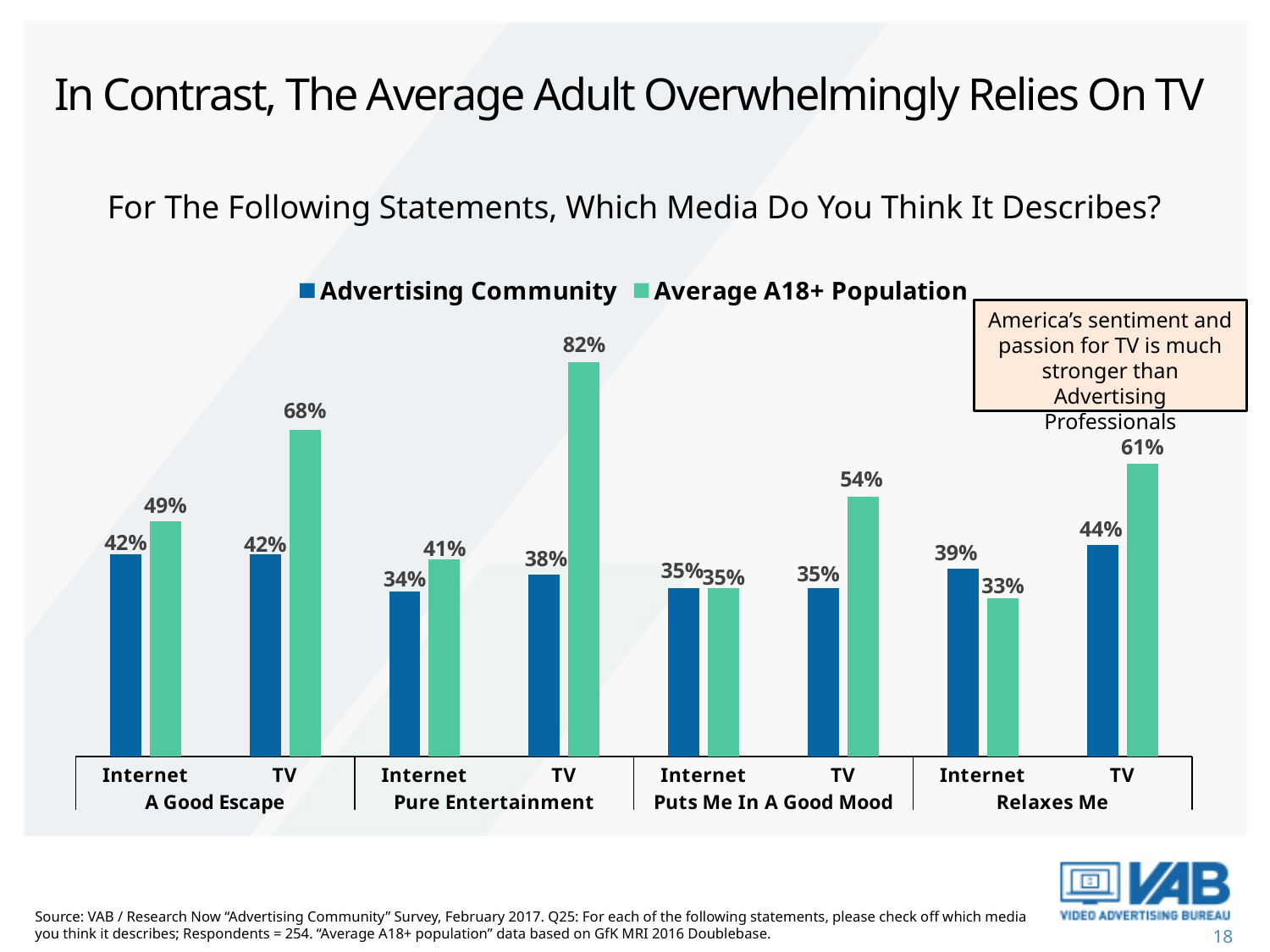
What is the Advertising Community value for Internet under Relaxes Me? 39% What kind of chart is shown on the slide? Bar chart How many statement groups are shown along the x axis? 4 Which colour represents the Average A18+ Population series? Green What is the difference between the Average A18+ Population and Advertising Community values for TV under Pure Entertainment? 44 percentage points Which bar has the highest value in the chart? Average A18+ Population, TV, Pure Entertainment (82%) What is the Average A18+ Population value for TV under A Good Escape? 68% How many series does the legend list? 2 What is the Advertising Community value for TV under Puts Me In A Good Mood? 35% For Internet under Relaxes Me, which is larger: the Advertising Community value or the Average A18+ Population value? Advertising Community Which bar has the lowest value in the chart? Average A18+ Population, Internet, Relaxes Me (33%) What is the Average A18+ Population value for TV under Pure Entertainment? 82%